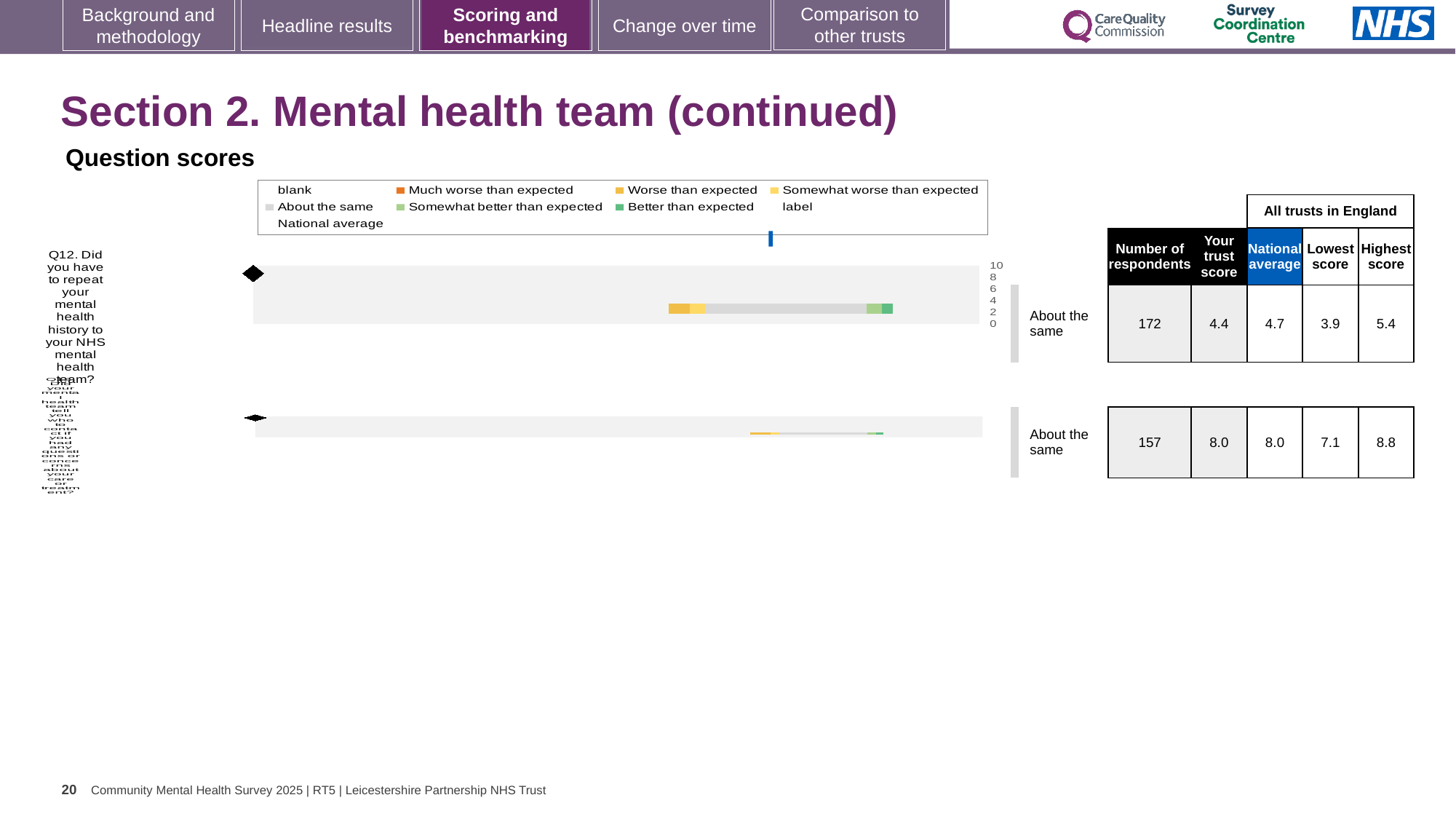
For Q12, which is larger: the trust score or the national average? National average Which legend entry is shown in orange? Much worse than expected For Q12, what is the difference between the highest score (5.4) and the lowest score (3.9) among all trusts in England? 1.5 For the second (lower) question chart, what is the number of respondents? 157 For Q12 (repeating your mental health history), what is the number of respondents shown in the table? 172 For Q12 (repeating your mental health history), what is 'Your trust score'? 4.4 For Q12 (repeating your mental health history), what is the highest score among all trusts in England? 5.4 How many question charts are shown on the slide? 2 What benchmark category is shown next to the Q12 chart? About the same For Q12 (repeating your mental health history), what is the national average? 4.7 For the second (lower) question chart, what is the lowest score among all trusts in England? 7.1 What kind of chart is used for the Q12 benchmarking chart? bar chart